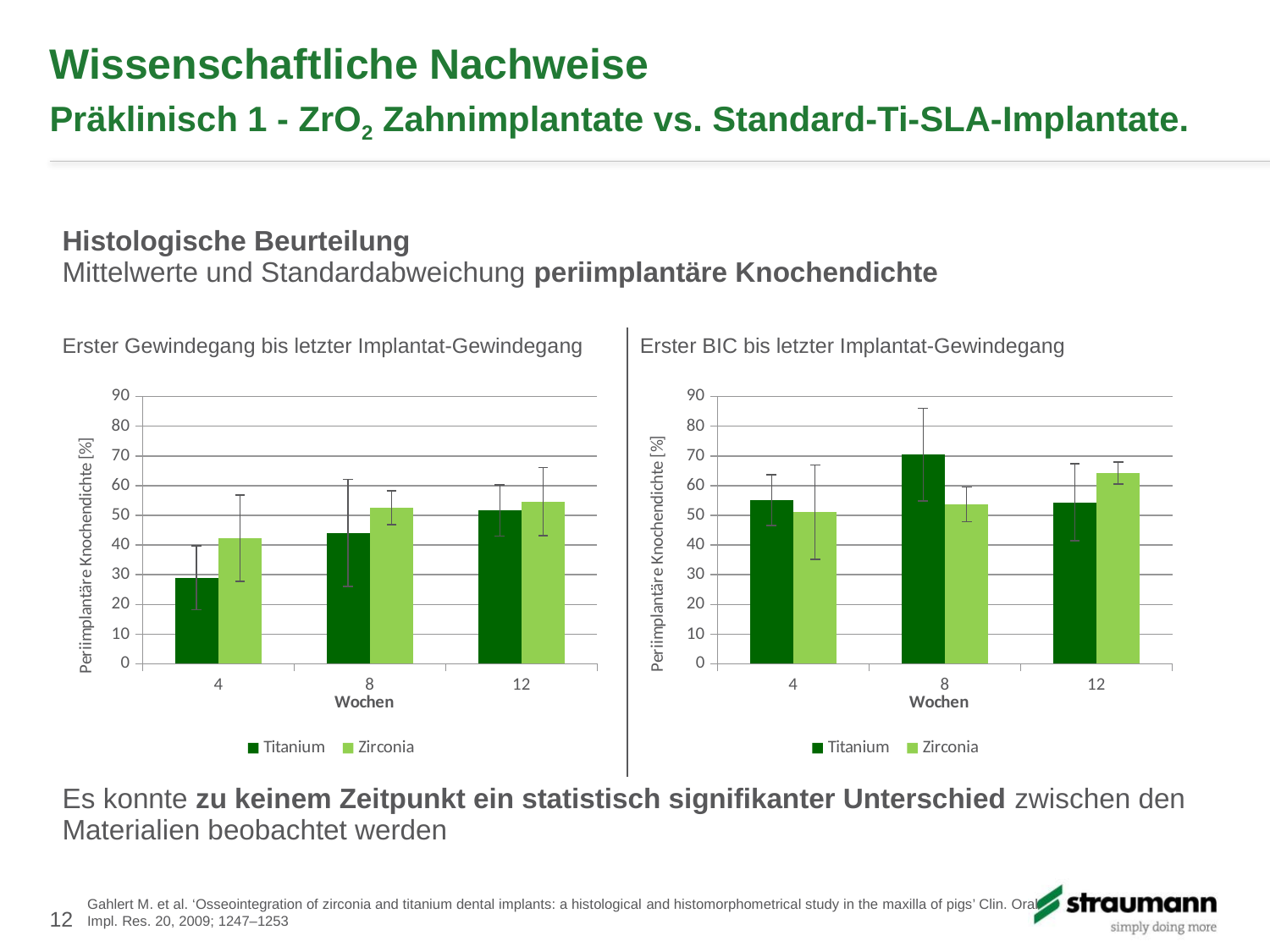
What kind of chart is the left chart, 'Erster Gewindegang bis letzter Implantat-Gewindegang'? bar chart In the right chart, 'Erster BIC bis letzter Implantat-Gewindegang', is the Titanium value at 8 Wochen greater or less than 60? greater In the right chart, 'Erster BIC bis letzter Implantat-Gewindegang', is the Zirconia value at 4 Wochen greater or less than 60? less In the left chart, 'Erster Gewindegang bis letzter Implantat-Gewindegang', which week has the lowest Titanium value? 4 What is the y-axis label of the left chart, 'Erster Gewindegang bis letzter Implantat-Gewindegang'? Periimplantäre Knochendichte [%] How many week categories are shown on the x axis of the left chart, 'Erster Gewindegang bis letzter Implantat-Gewindegang'? 3 How many series does the legend of the right chart, 'Erster BIC bis letzter Implantat-Gewindegang', list? 2 In the left chart, 'Erster Gewindegang bis letzter Implantat-Gewindegang', is the Titanium value at 4 Wochen greater or less than 40? less In the right chart, 'Erster BIC bis letzter Implantat-Gewindegang', which is larger at 12 Wochen, Titanium or Zirconia? Zirconia In the left chart, 'Erster Gewindegang bis letzter Implantat-Gewindegang', do the Titanium values rise or fall from 4 to 12 Wochen? rise In the right chart, 'Erster BIC bis letzter Implantat-Gewindegang', which week has the highest Titanium value? 8 In the left chart, 'Erster Gewindegang bis letzter Implantat-Gewindegang', which is larger at 4 Wochen, Titanium or Zirconia? Zirconia